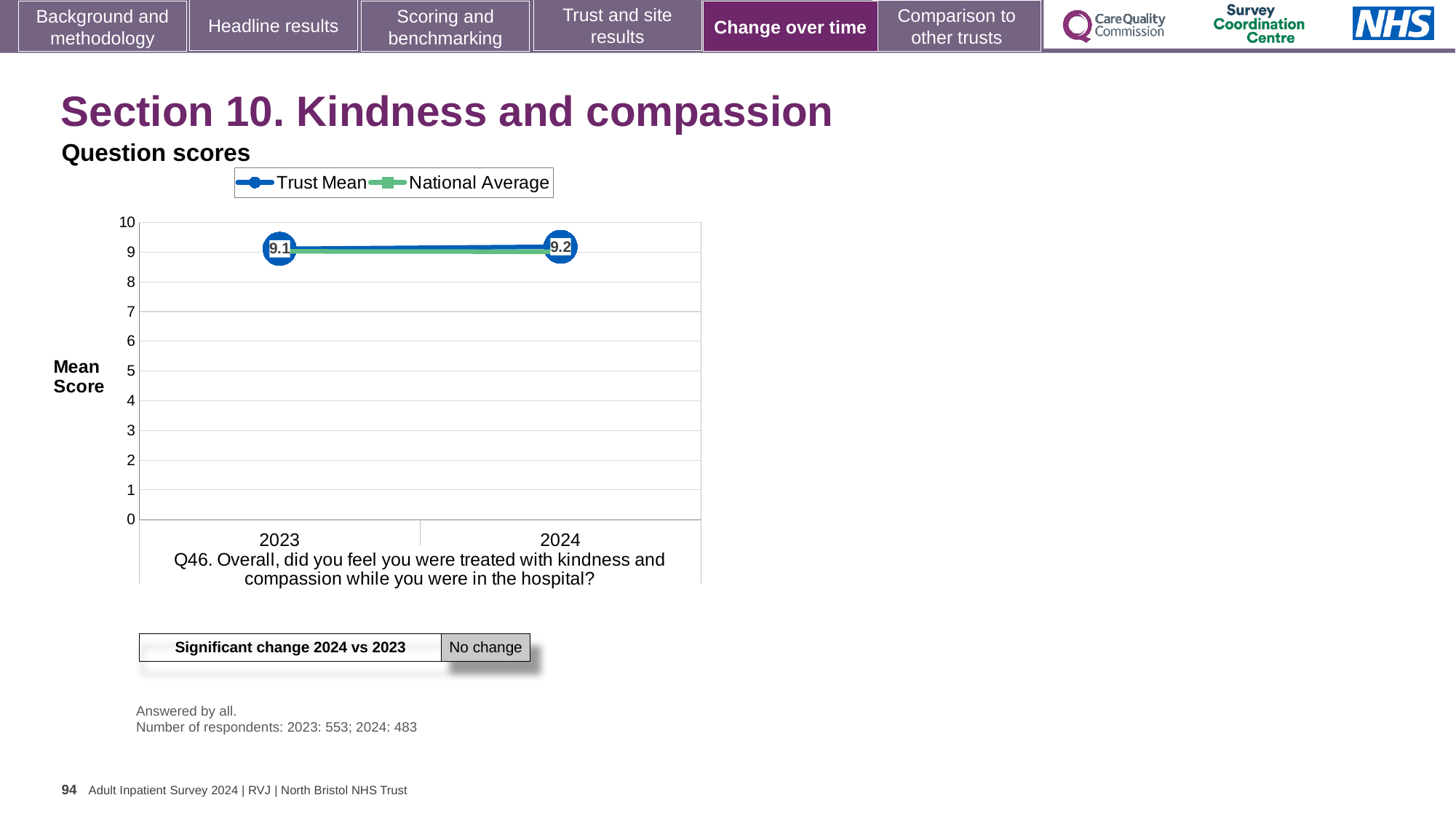
Is the Trust Mean value for 2023 greater or less than 8? greater Which year has the higher Trust Mean score, 2023 or 2024? 2024 How many series does the legend list? 2 What kind of chart is shown on the slide? line chart How many years are plotted on the x axis? 2 What is the Trust Mean score for 2024? 9.2 What are the two series named in the legend? Trust Mean and National Average Is the National Average value for 2024 greater or less than 5? greater Does the Trust Mean rise or fall from 2023 to 2024? rise What is the difference between the Trust Mean scores for 2024 and 2023? 0.1 What is the label on the y axis of the chart? Mean Score What is the Trust Mean score for 2023? 9.1